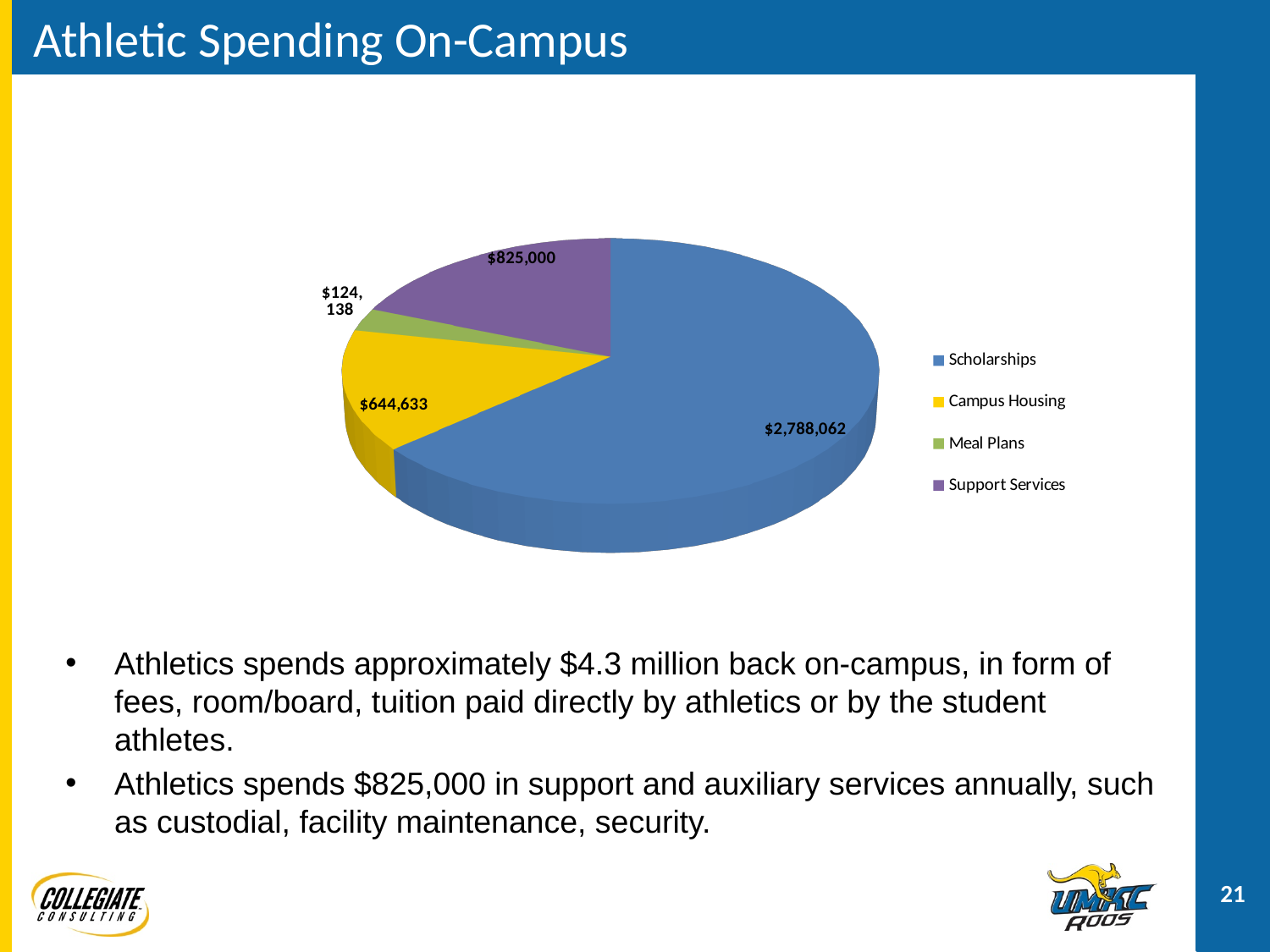
What is the value shown for Meal Plans? $124,138 What is the difference between the Scholarships value and the Campus Housing value? $2,143,429 What is the value shown for Scholarships? $2,788,062 What is the value shown for Support Services? $825,000 Which category has the largest slice of the pie? Scholarships How many slices does the pie chart have? 4 What type of chart is shown on the slide? Pie chart What is the difference between the Support Services value and the Campus Housing value? $180,367 What colour is the Support Services slice in the pie chart? Purple Which is larger, Campus Housing or Support Services? Support Services What is the value shown for Campus Housing? $644,633 Which category has the smallest slice of the pie? Meal Plans